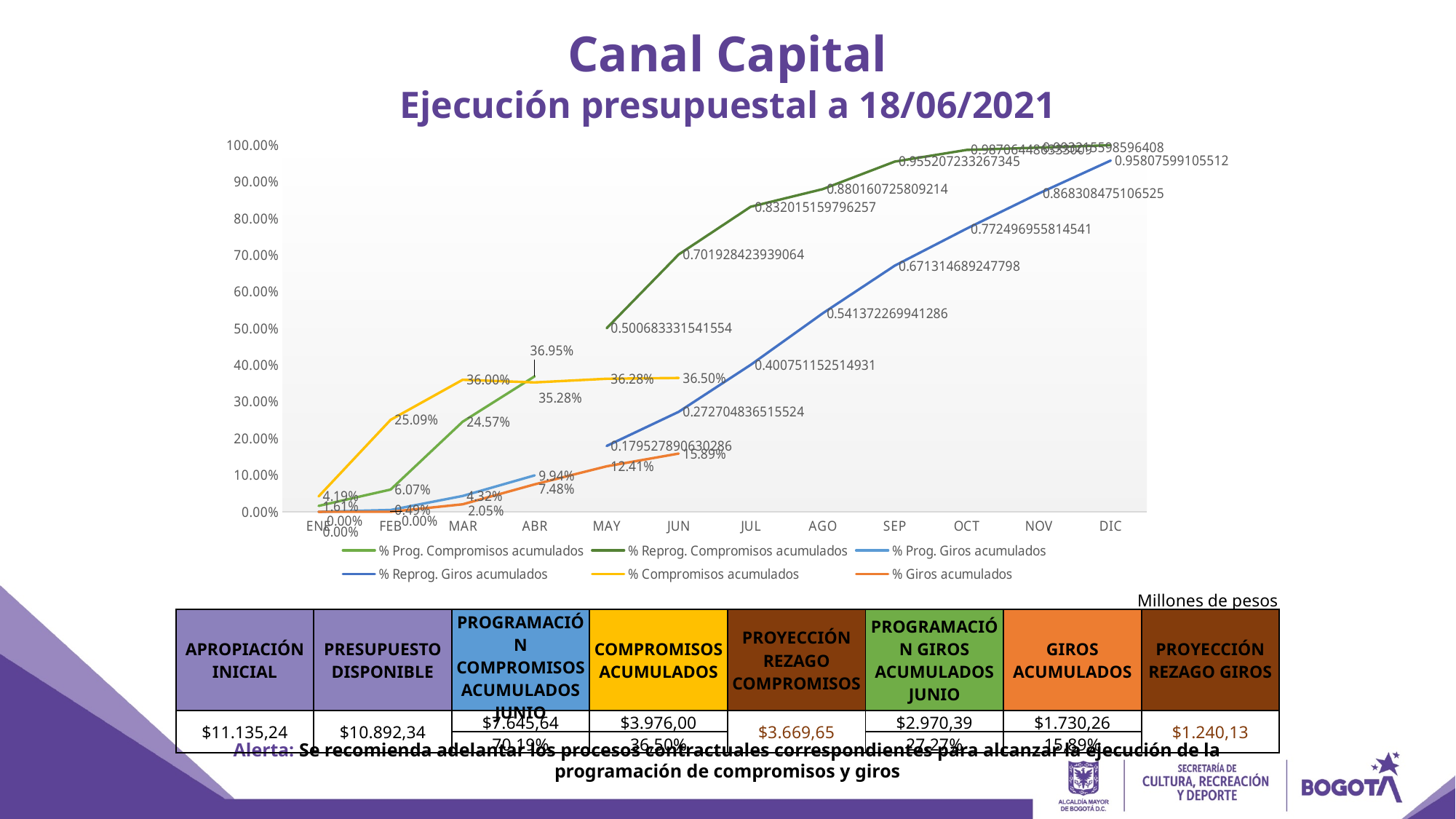
What is the value of % Reprog. Compromisos acumulados in JUN? 0.701928423939064 What is the value of % Compromisos acumulados in JUN? 36.50% Does the % Reprog. Giros acumulados series rise or fall from MAY to DIC? rise How many series does the chart legend list? 6 What is the value of % Reprog. Giros acumulados in DIC? 0.95807599105512 How many months are shown on the x axis of the chart? 12 What is the value of % Giros acumulados in JUN? 15.89% What is the value of % Prog. Giros acumulados in ABR? 9.94% What is the difference between the % Giros acumulados values for JUN and MAY? 3.48% What kind of chart is shown on the slide? line chart What is the value of % Compromisos acumulados in FEB? 25.09% In JUN, which is larger: % Reprog. Compromisos acumulados or % Reprog. Giros acumulados? % Reprog. Compromisos acumulados